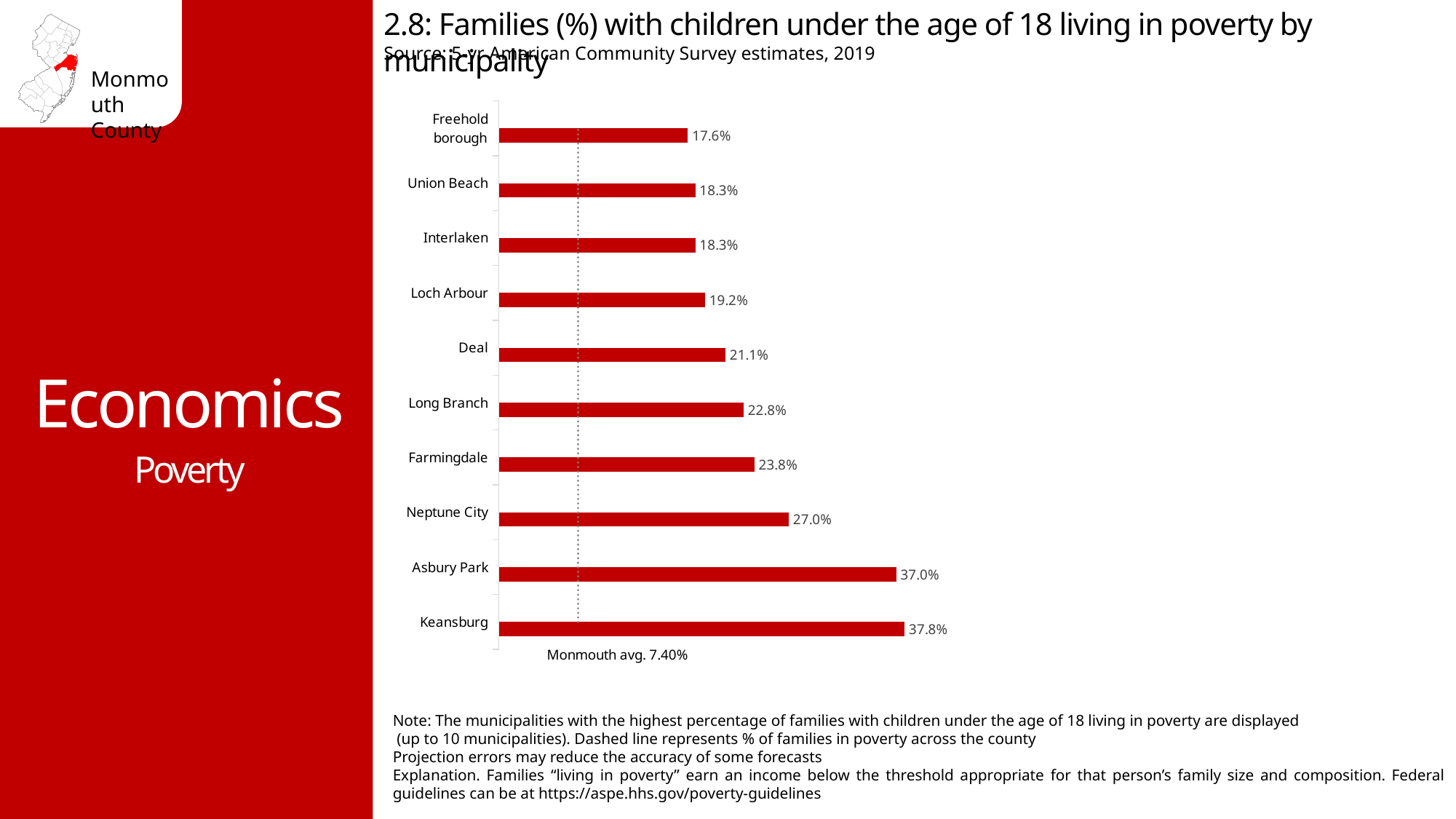
Which has a higher value, Long Branch or Deal? Long Branch What percentage of families with children under 18 are living in poverty in Keansburg? 37.8% Which two municipalities share the same value of 18.3%? Union Beach and Interlaken What is the difference between the values for Farmingdale and Loch Arbour? 4.6% What is the value shown for Neptune City? 27.0% How many municipalities are shown on the chart? 10 What is the difference between the values for Asbury Park and Neptune City? 10.0% What is the value shown for Freehold borough? 17.6% Which municipality has the lowest value on the chart? Freehold borough What kind of chart is shown on the slide? Bar chart What is the Monmouth County average shown by the dashed line? 7.40% Which municipality has the highest percentage of families with children under 18 living in poverty? Keansburg